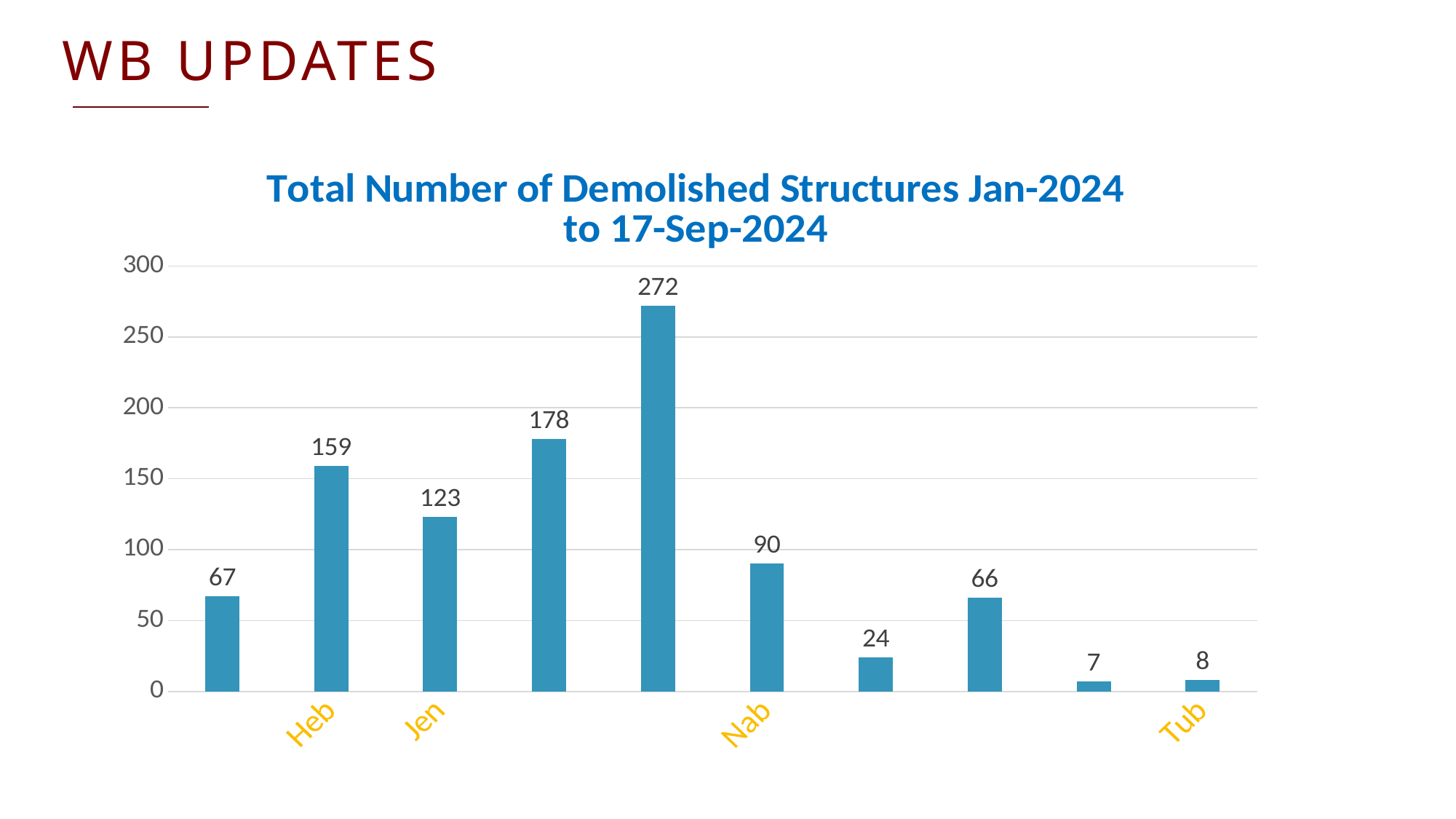
Is the value for Heb greater or less than 150? greater What is the highest value shown on the chart? 272 What is the lowest value shown on the chart? 7 What is the value for Heb? 159 What is the value for Jen? 123 What is the value for Tub? 8 What is the title of the chart? Total Number of Demolished Structures Jan-2024 to 17-Sep-2024 What kind of chart is shown on the slide? Bar chart What is the value for Nab? 90 Which is larger, the value for Nab or the value for Tub? Nab What is the difference between the values for Heb and Jen? 36 How many bars are plotted on the chart? 10